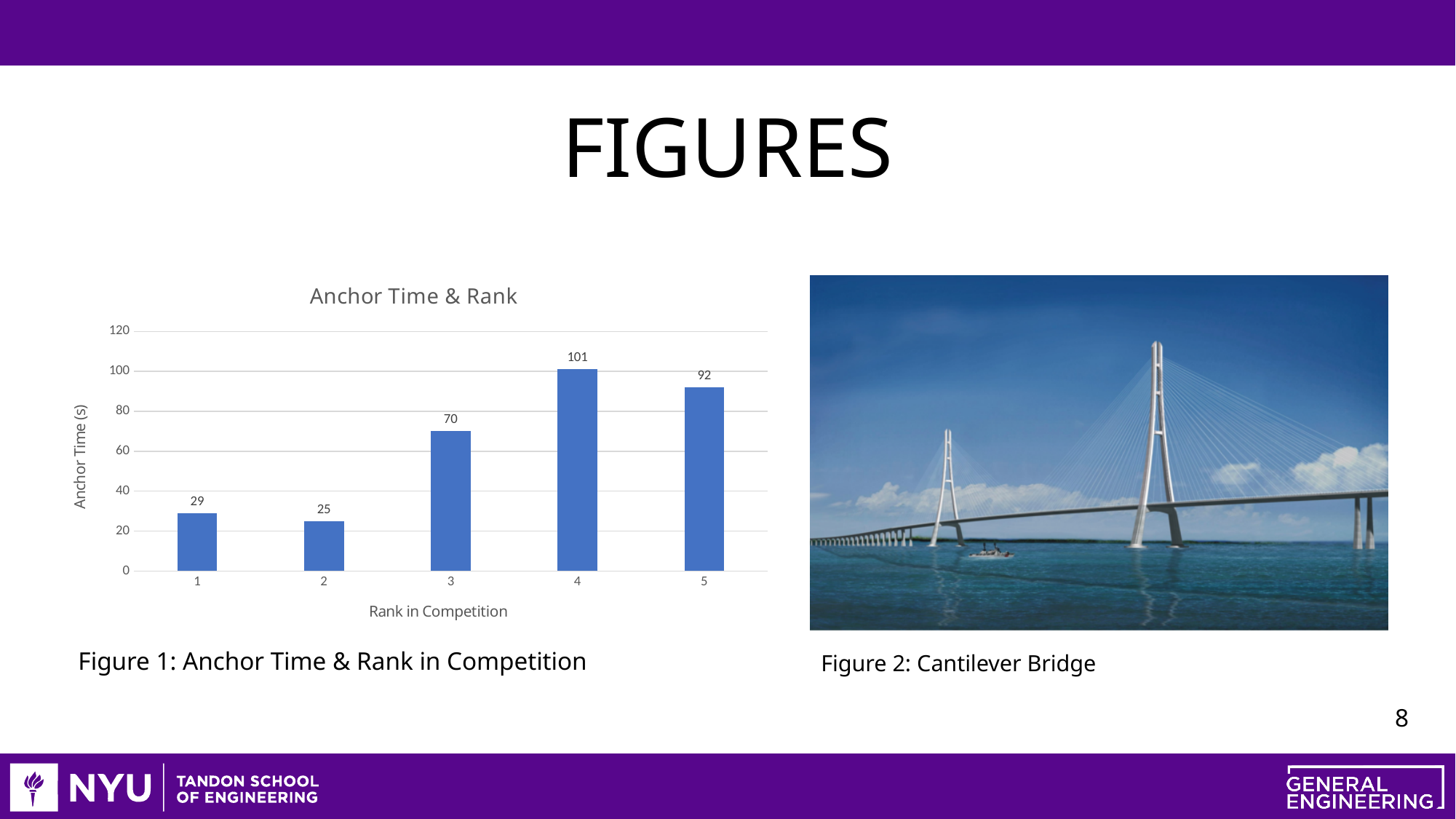
What is the anchor time for rank 4 in the Anchor Time & Rank chart? 101 What is the anchor time for rank 5 in the Anchor Time & Rank chart? 92 How many ranks are plotted in the Anchor Time & Rank chart? 5 What is the anchor time for rank 2 in the Anchor Time & Rank chart? 25 What is the difference in anchor time between rank 4 and rank 5 in the Anchor Time & Rank chart? 9 What is the y-axis label of the Anchor Time & Rank chart? Anchor Time (s) Is the anchor time for rank 3 in the Anchor Time & Rank chart greater or less than 60? greater What is the difference in anchor time between rank 3 and rank 1 in the Anchor Time & Rank chart? 41 Which rank has the highest anchor time in the Anchor Time & Rank chart? 4 What type of chart is the Anchor Time & Rank chart? bar chart Which rank has the lowest anchor time in the Anchor Time & Rank chart? 2 In the Anchor Time & Rank chart, which has a larger anchor time, rank 1 or rank 2? rank 1